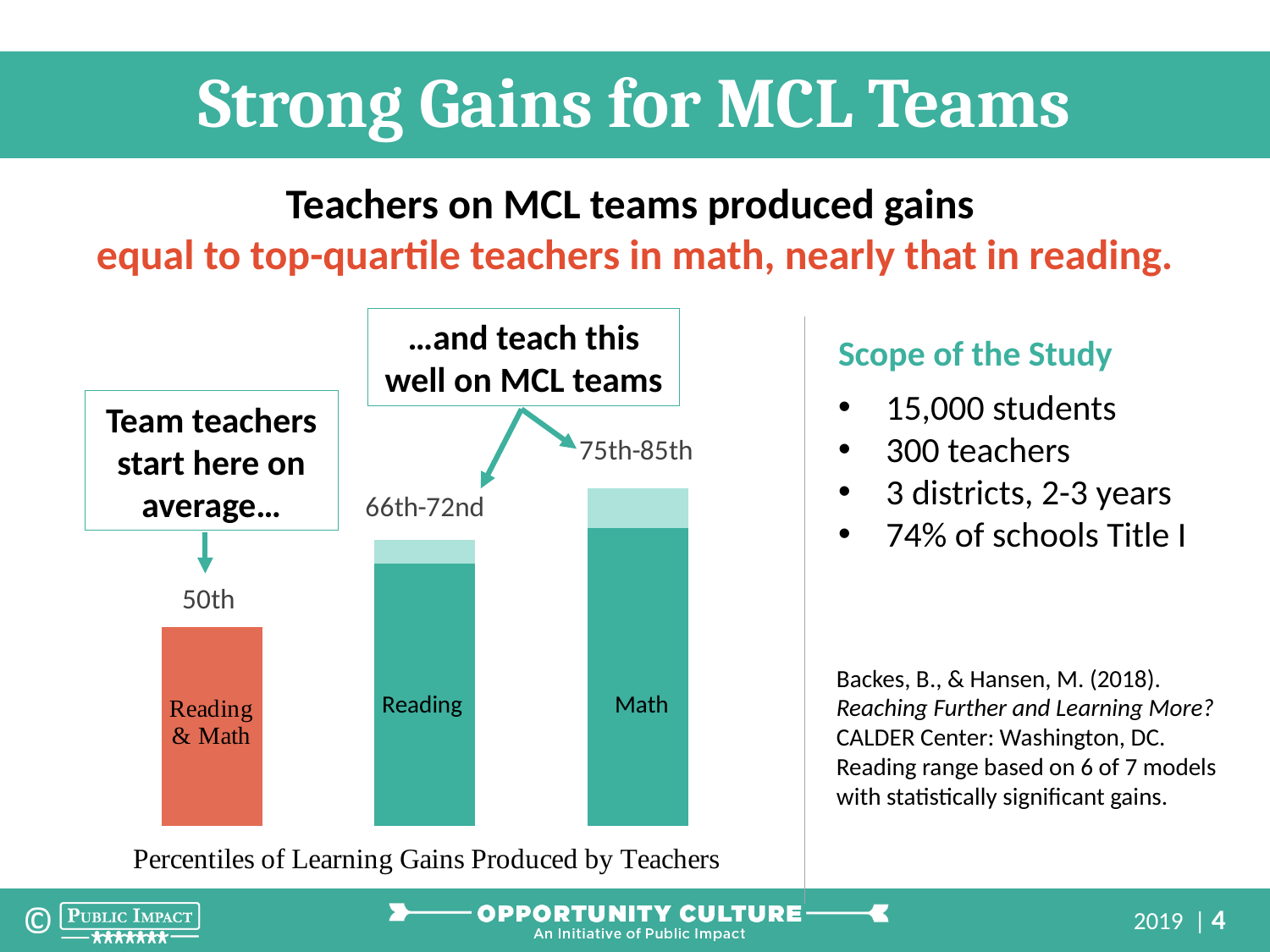
Which bar in the chart is the tallest? Math What percentile range is shown above the "Math" bar for MCL teams? 75th-85th What colour is the "Reading & Math" bar? Orange-red What kind of chart is shown on the slide? Bar chart What percentile label is shown above the "Reading & Math" bar? 50th Which bar is taller, the "Reading & Math" bar or the "Reading" bar? Reading Which bar is taller, the "Reading" bar or the "Math" bar? Math Do the bar heights rise or fall from left to right across the chart? Rise How many bars are shown in the chart? 3 What percentile range is shown above the "Reading" bar for MCL teams? 66th-72nd Which bar in the chart is the shortest? Reading & Math What is the caption printed below the chart? Percentiles of Learning Gains Produced by Teachers